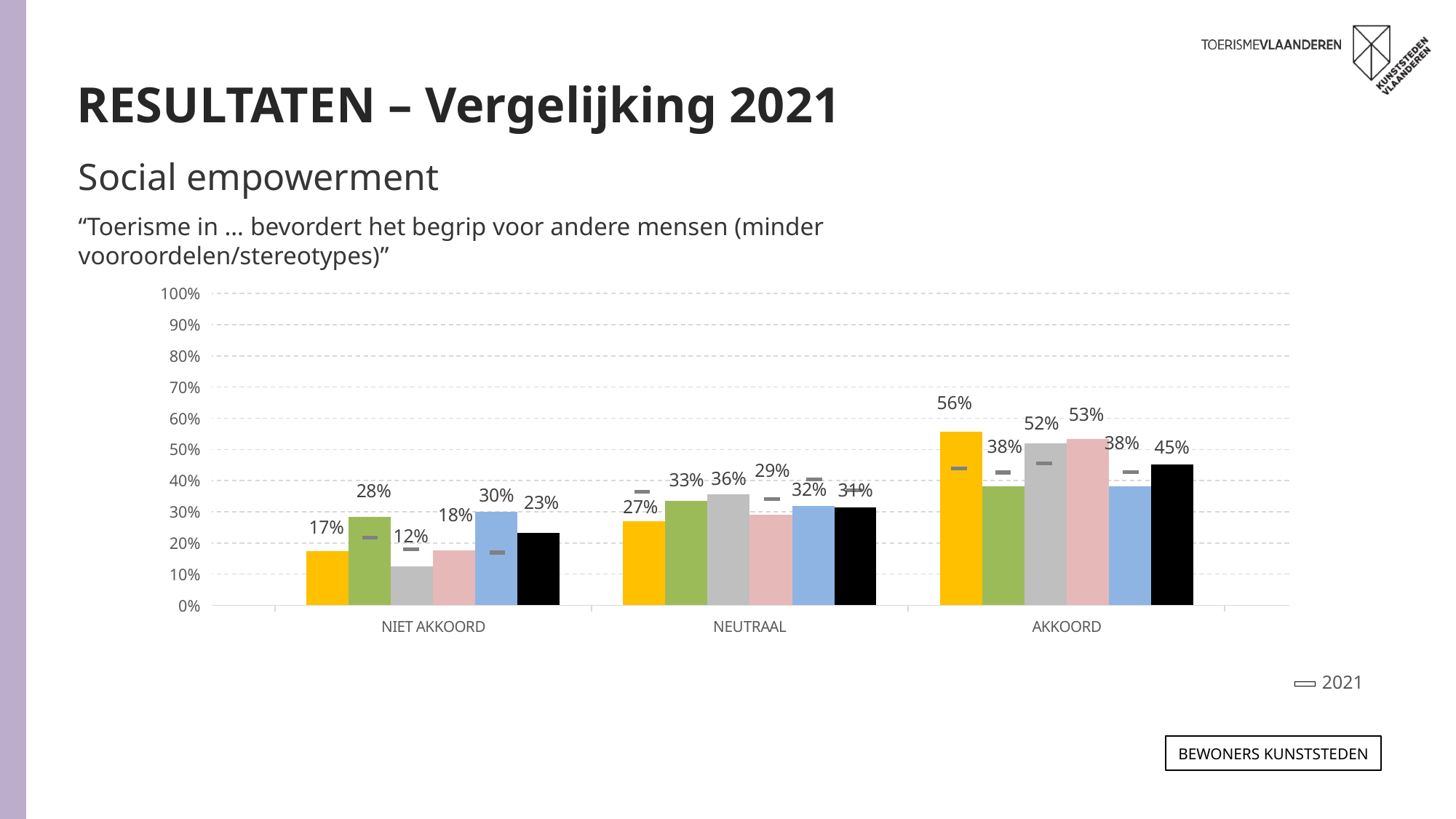
What is the difference between the yellow bar in AKKOORD and the yellow bar in NIET AKKOORD? 39% What is the value of the yellow bar in the AKKOORD category? 56% Which coloured bar is the highest in the AKKOORD category? yellow What is the value of the black bar in the NEUTRAAL category? 31% How many entries does the chart legend list? 1 Which is larger in the NEUTRAAL category: the grey bar or the pink bar? grey bar What is the value of the grey bar in the NIET AKKOORD category? 12% Is the value of the pink bar in the AKKOORD category greater or less than 50%? greater How many categories are shown on the x axis of the chart? 3 Which coloured bar is the lowest in the NIET AKKOORD category? grey What label does the chart legend show? 2021 What type of chart is shown on the slide? bar chart